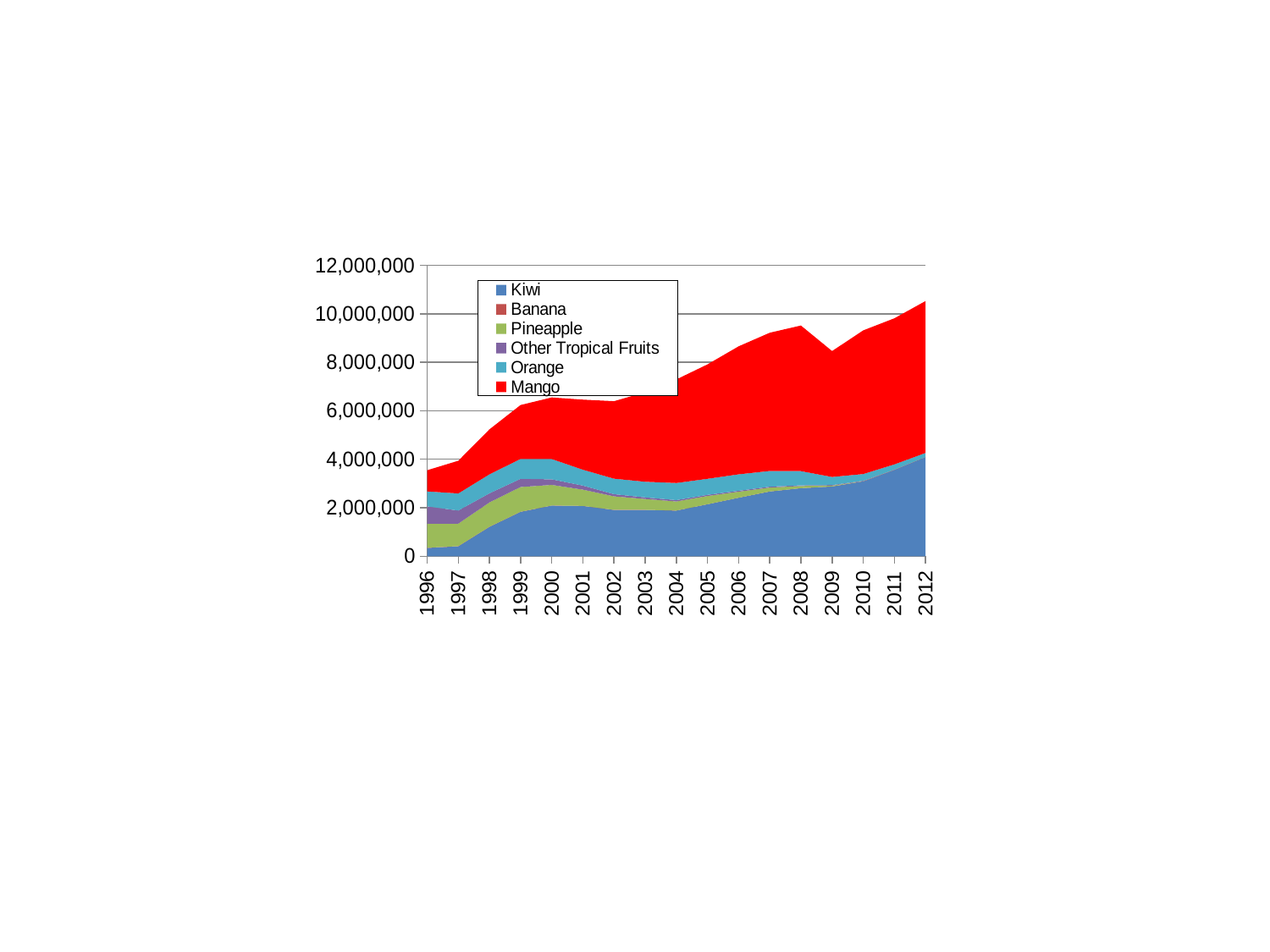
Does the Kiwi series generally rise or fall from 1996 to 2012? rise How many years are shown along the x axis? 17 Which year has the lowest total stacked value? 1996 Is the Kiwi value for 1996 greater or less than 2,000,000? less Is the total stacked value for 1996 greater or less than 4,000,000? less What kind of chart is shown on the slide? Stacked area chart How many series does the legend list? 6 Is the total stacked value for 2008 greater or less than 8,000,000? greater Which year has the larger total stacked value, 2008 or 2009? 2008 Which year has the highest total stacked value? 2012